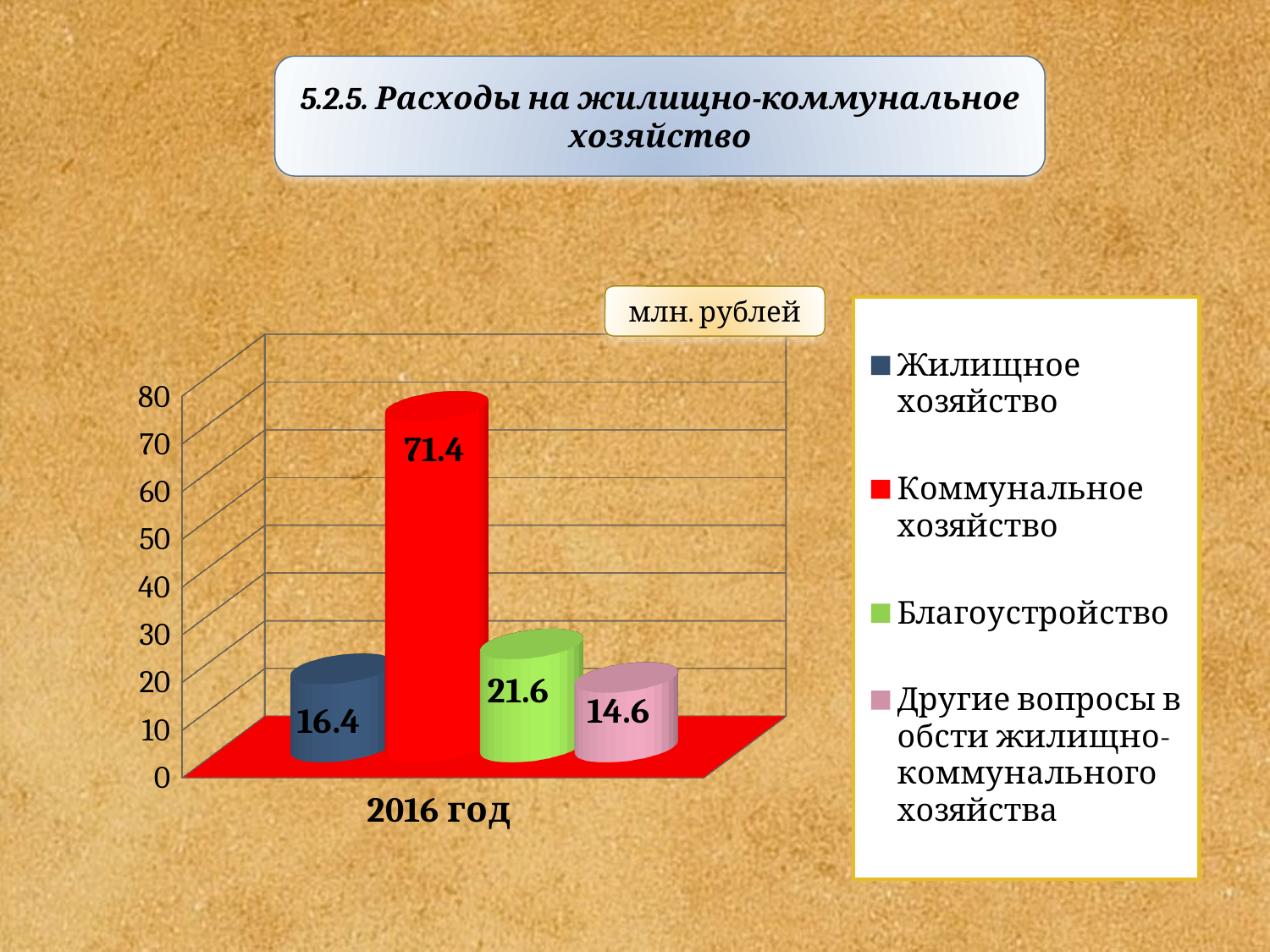
What is the difference between the values for Коммунальное хозяйство and Благоустройство? 49.8 Which series has the highest value in 2016 год? Коммунальное хозяйство How many series does the legend list? 4 What is the value for Благоустройство in 2016 год? 21.6 What is the value for Жилищное хозяйство in 2016 год? 16.4 What is the value for Другие вопросы в обсти жилищно-коммунального хозяйства in 2016 год? 14.6 What unit is shown in the label above the chart? млн. рублей What kind of chart is shown on the slide? bar chart Is the value for Коммунальное хозяйство greater or less than 60? greater Which series has the lowest value in 2016 год? Другие вопросы в обсти жилищно-коммунального хозяйства What is the value for Коммунальное хозяйство in 2016 год? 71.4 Which is larger, the value for Жилищное хозяйство or the value for Благоустройство? Благоустройство